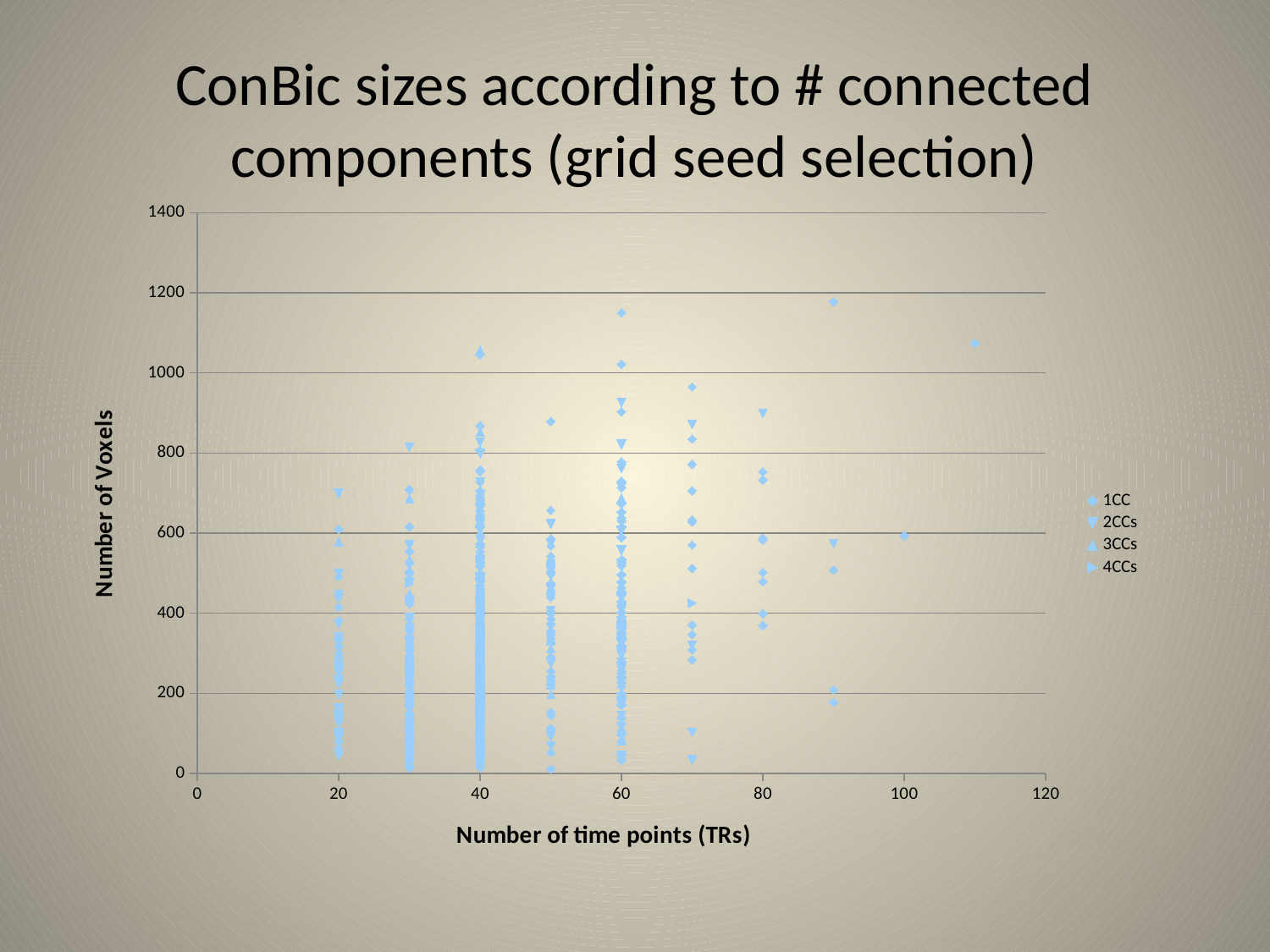
Is the highest point plotted at 110 time points greater or less than 1100 voxels? less What is the title of the vertical axis? Number of Voxels How many distinct values of Number of time points (TRs) have data points plotted? 10 Is the highest point plotted at 60 time points greater or less than 1100 voxels? greater Is the highest point plotted at 90 time points greater or less than 1100 voxels? greater What kind of chart is shown on the slide? scatter chart How many series does the legend list? 4 What are the series names listed in the legend? 1CC, 2CCs, 3CCs, 4CCs Which has a higher maximum number of voxels: the points at 20 time points or the points at 40 time points? 40 time points